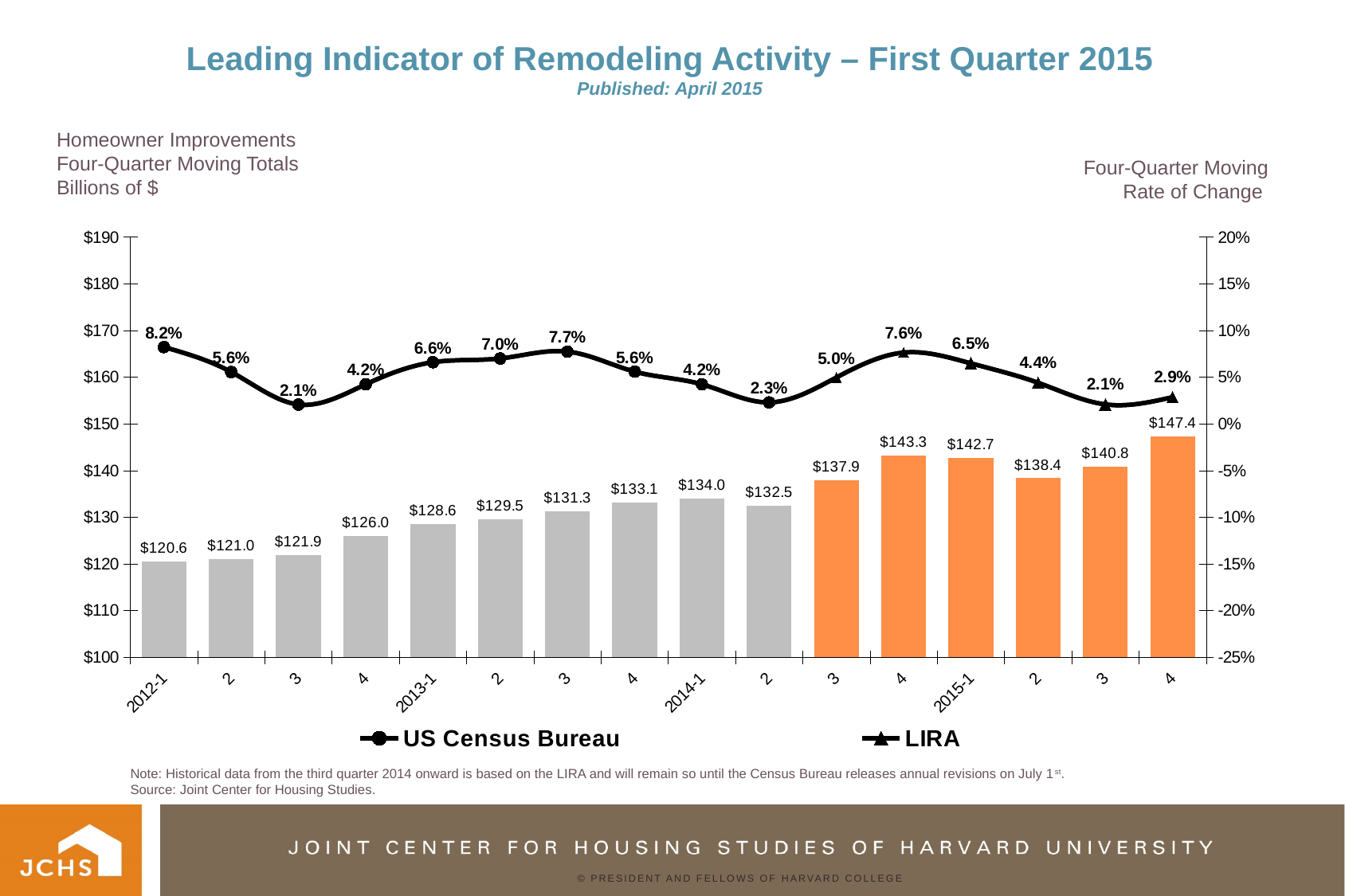
What is the difference between the four-quarter moving totals for 2015-4 and 2015-3? $6.6 What is the rate of change shown for the last quarter on the chart (2015-4)? 2.9% Which has the larger four-quarter moving total, 2014-1 or 2014-2? 2014-1 Which quarter has the highest four-quarter moving total? 2015-4 Do the four-quarter moving totals rise or fall from 2012-1 to 2014-1? Rise How many quarters (bars) are plotted on the chart? 16 What is the four-quarter moving total for 2015-1? $142.7 Which quarter has the highest four-quarter moving rate of change? 2012-1 What kind of chart is used to show the four-quarter moving totals in billions of dollars? Bar chart Which quarter has the lowest four-quarter moving total? 2012-1 What is the four-quarter moving rate of change shown for 2014-1? 4.2% How many series does the legend list? 2